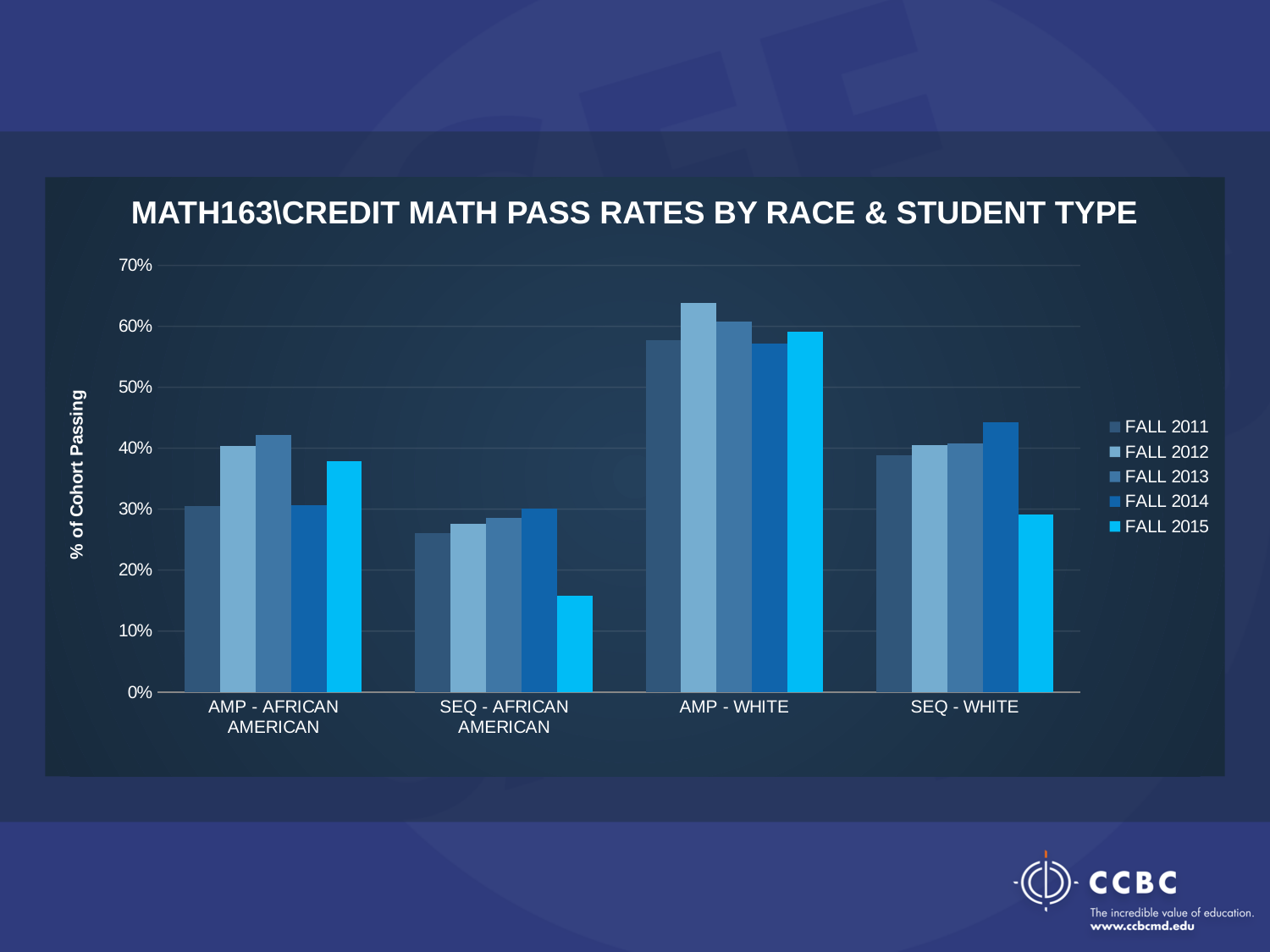
Which is larger for FALL 2011: the value for AMP - WHITE or the value for SEQ - WHITE? AMP - WHITE Is the FALL 2012 value for AMP - WHITE greater or less than 60%? greater Is the FALL 2011 value for AMP - AFRICAN AMERICAN greater or less than 40%? less Which category has the lowest FALL 2015 pass rate? SEQ - AFRICAN AMERICAN Is the FALL 2015 value for SEQ - AFRICAN AMERICAN greater or less than 20%? less How many categories are shown on the x axis? 4 What is the title of the y axis? % of Cohort Passing Which category has the highest FALL 2012 pass rate? AMP - WHITE How many series does the legend list? 5 Which series has the highest value in the SEQ - WHITE category? FALL 2014 What kind of chart is shown on the slide? Bar chart